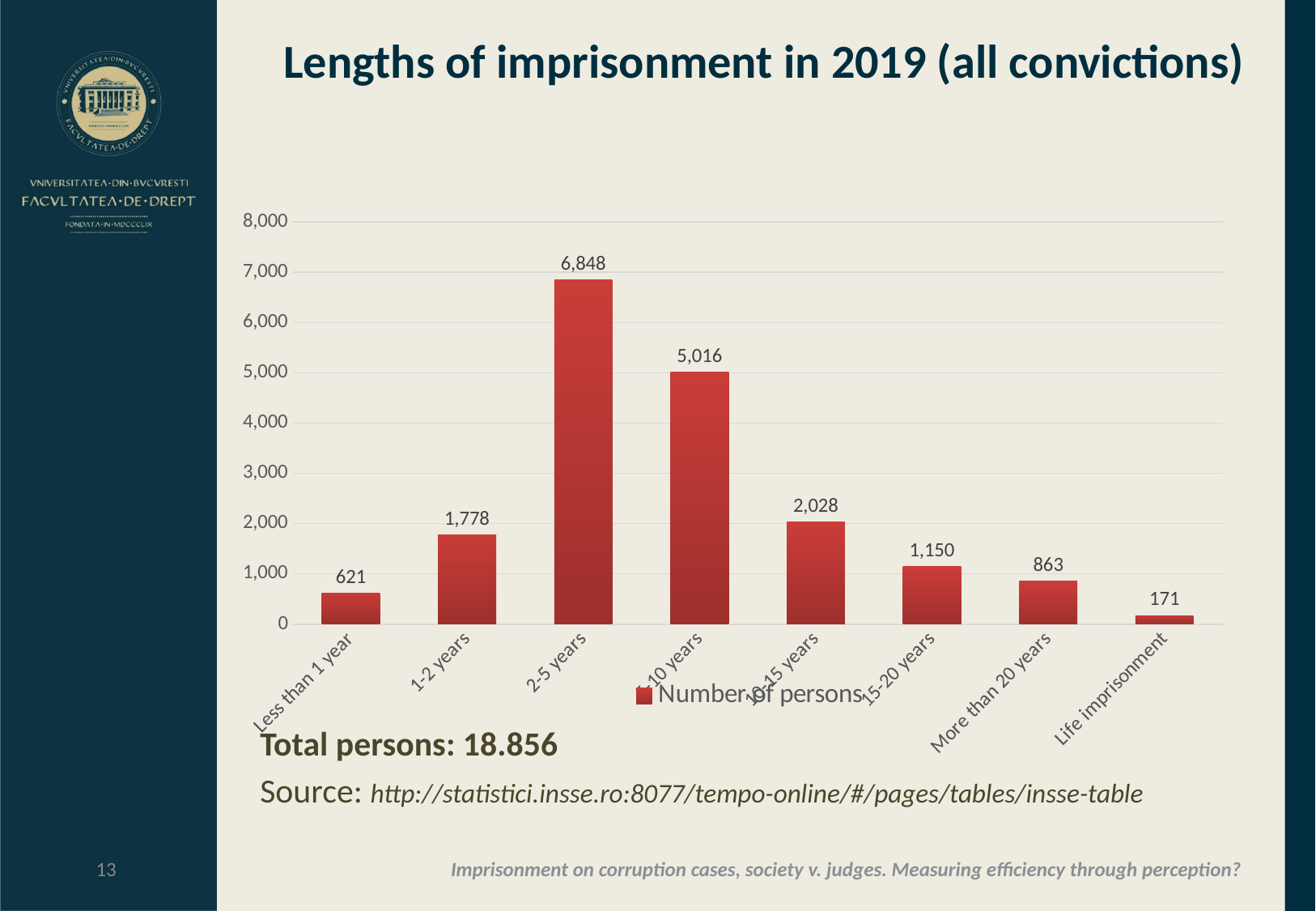
How many persons were sentenced to 2-5 years of imprisonment? 6,848 Which imprisonment length category has the lowest number of persons? Life imprisonment What is the difference between the number of persons for '1-2 years' and 'Less than 1 year'? 1,157 How many series does the legend list? 1 What is the number of persons for the '15-20 years' category? 1,150 What type of chart is shown on the slide? Bar chart What is the title of the chart? Lengths of imprisonment in 2019 (all convictions) What is the number of persons for the 'Less than 1 year' category? 621 What is the number of persons for 'Life imprisonment'? 171 Which has more persons: '10-15 years' or 'More than 20 years'? 10-15 years Which imprisonment length category has the highest number of persons? 2-5 years How many imprisonment length categories are shown on the x axis? 8